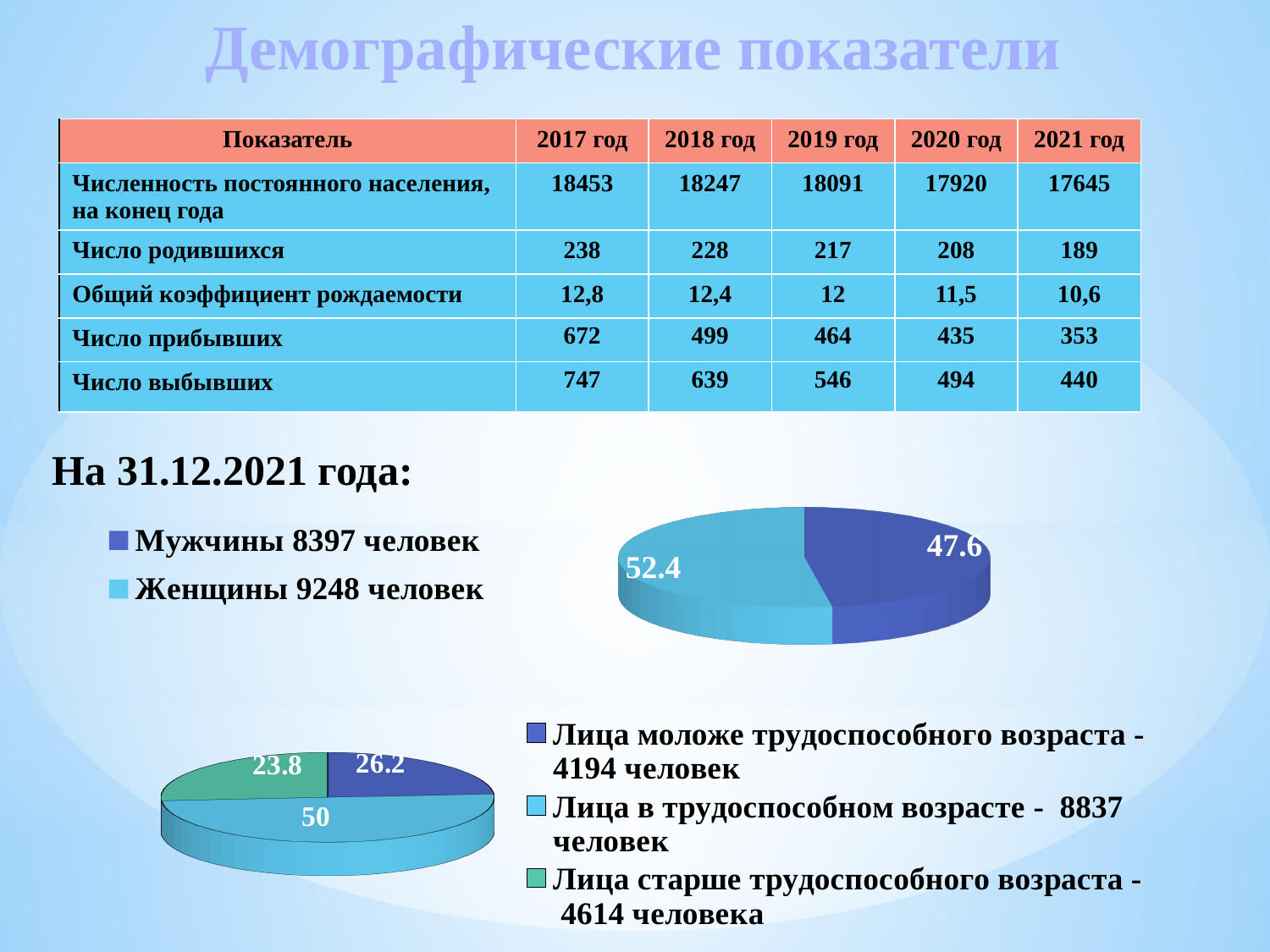
In the lower pie chart, which category has the smallest slice? Лица старше трудоспособного возраста In the lower pie chart, what value is shown for 'Лица моложе трудоспособного возраста'? 26.2 How many slices does the lower pie chart have? 3 In the upper pie chart, what value is shown for the slice 'Мужчины 8397 человек'? 47.6 How many entries does the legend of the upper pie chart list? 2 In the upper pie chart, what is the difference between the 'Женщины' value and the 'Мужчины' value? 4.8 In the upper pie chart, which slice is larger: 'Мужчины' or 'Женщины'? Женщины In the lower pie chart, what value is shown for 'Лица в трудоспособном возрасте'? 50 In the lower pie chart, what value is shown for 'Лица старше трудоспособного возраста'? 23.8 In the upper pie chart, what value is shown for the slice 'Женщины 9248 человек'? 52.4 In the lower pie chart, which category has the largest slice? Лица в трудоспособном возрасте What type of chart is the upper chart on the slide (next to 'На 31.12.2021 года')? pie chart